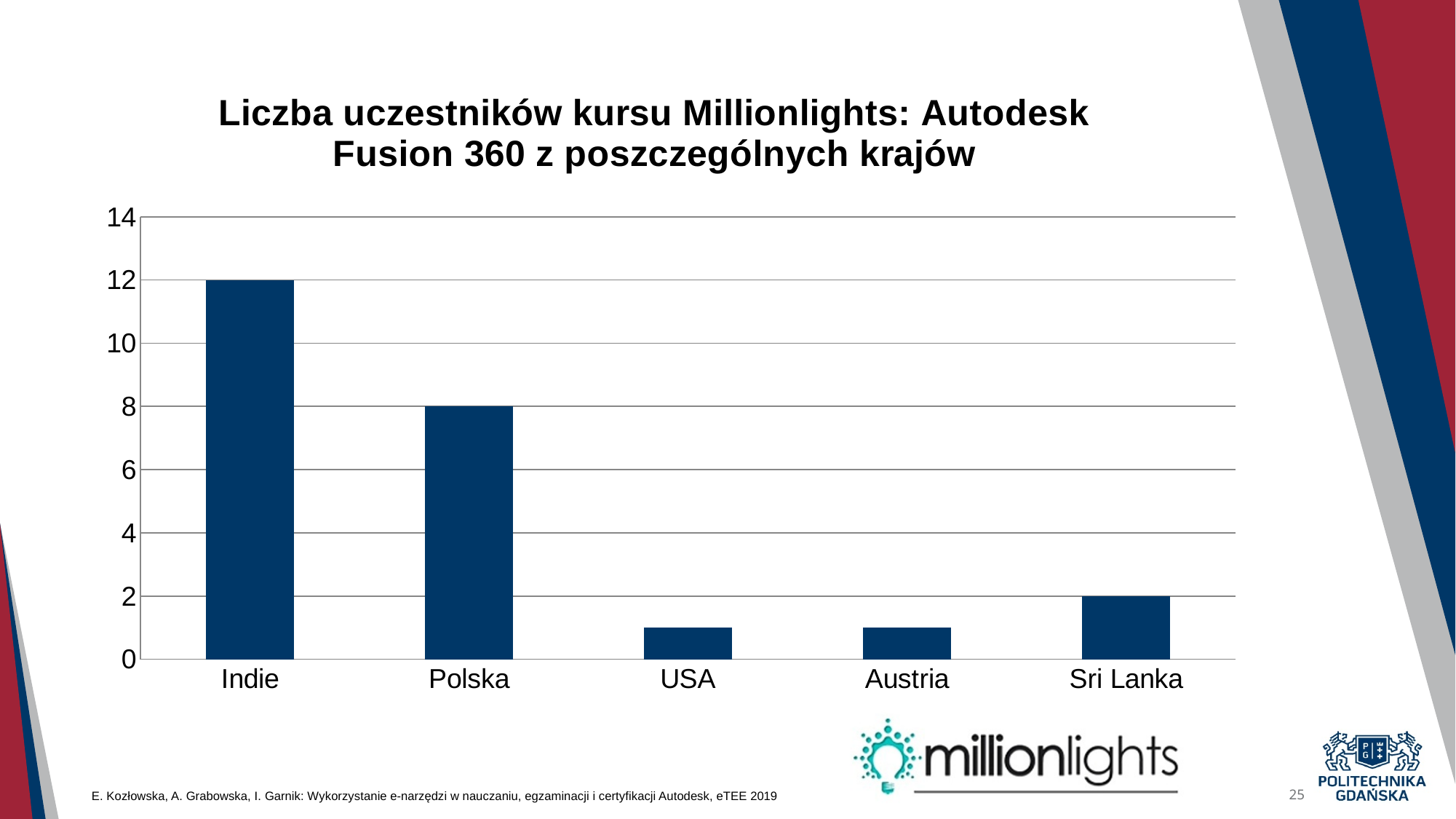
What is the difference between the values for Indie and Polska? 4 Which is larger, the value for Polska or the value for Sri Lanka? Polska What is the value for Sri Lanka? 2 Is the value for Austria greater or less than 2? less Is the value for USA greater or less than 2? less What is the value for Polska? 8 Is the value for Indie greater or less than 10? greater What is the value for Indie? 12 What is the title of the chart? Liczba uczestników kursu Millionlights: Autodesk Fusion 360 z poszczególnych krajów How many countries are shown on the x axis? 5 What kind of chart is shown on the slide? bar chart Which country has the highest number of participants? Indie